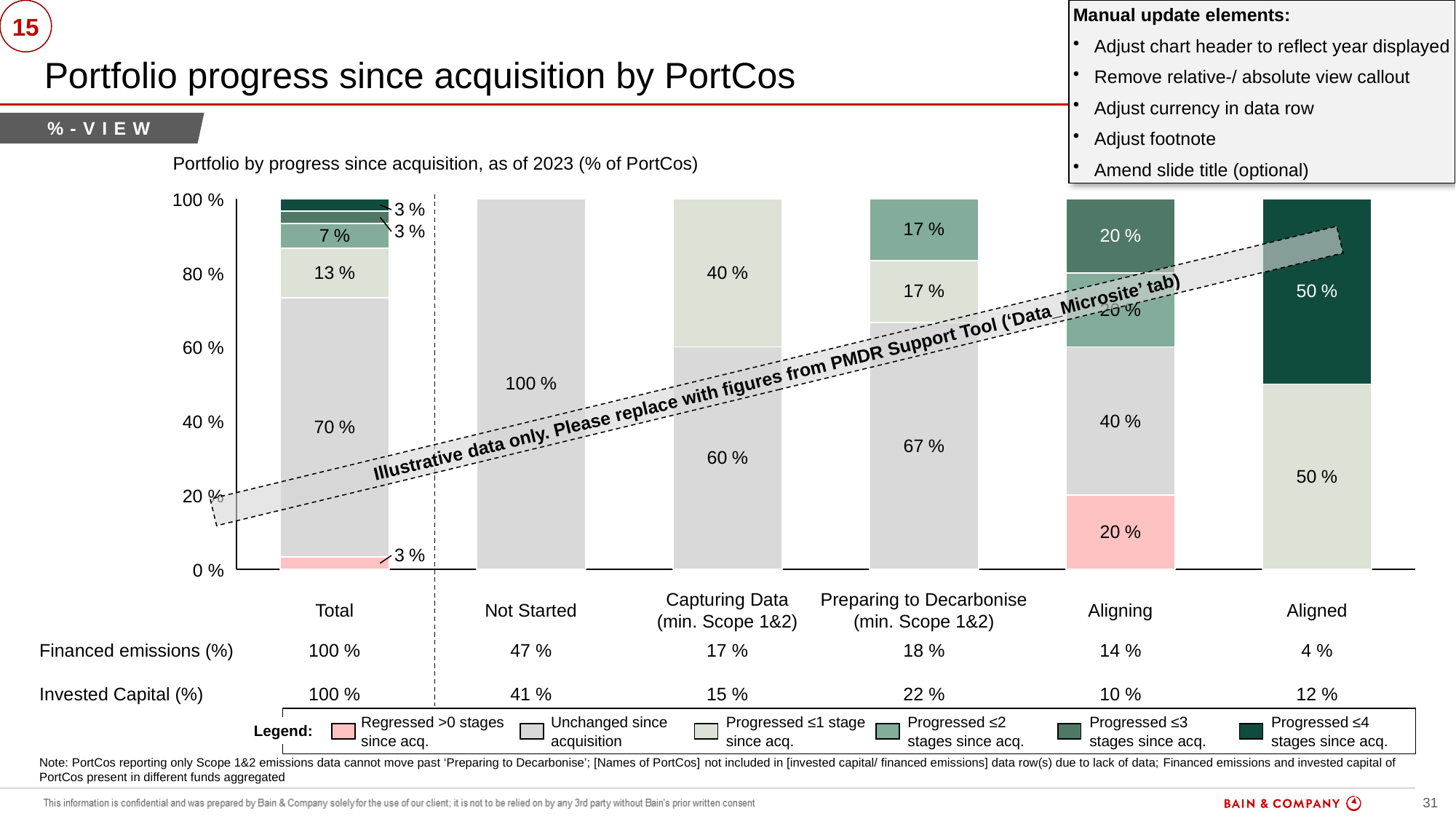
In the Total bar, which segment is larger: 'Unchanged since acquisition' or 'Progressed ≤1 stage since acq.'? Unchanged since acquisition What is the value of the 'Unchanged since acquisition' segment for the Not Started category? 100 % In the Capturing Data (min. Scope 1&2) bar, what is the difference between the 'Unchanged since acquisition' segment and the 'Progressed ≤1 stage since acq.' segment? 20 % What is the title of the chart? Portfolio by progress since acquisition, as of 2023 (% of PortCos) What percentage of PortCos in the Total bar are 'Unchanged since acquisition'? 70 % What share of the Capturing Data (min. Scope 1&2) bar is 'Progressed ≤1 stage since acq.'? 40 % How many categories are shown along the x axis of the chart? 6 What kind of chart is shown on the slide? Stacked bar chart What is the 'Progressed ≤4 stages since acq.' value for the Aligned category? 50 % How many series does the chart legend list? 6 What percentage of the Aligning bar is 'Regressed >0 stages since acq.'? 20 % What is the 'Unchanged since acquisition' value for Preparing to Decarbonise (min. Scope 1&2)? 67 %